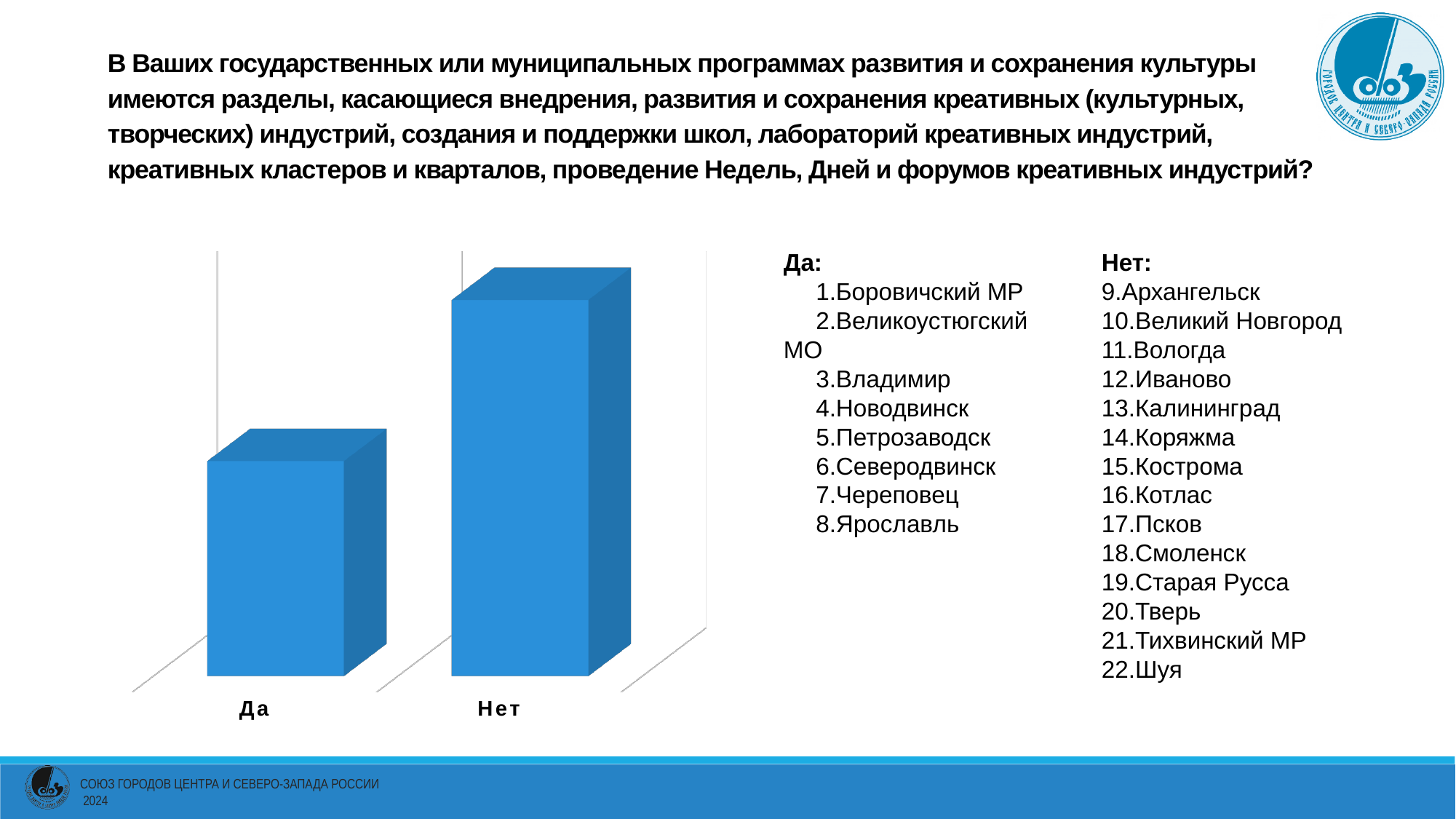
Which category has the highest bar in the chart? Нет What kind of chart is shown on the slide? bar chart What are the category labels on the x axis of the chart? Да, Нет How many categories are shown on the x axis of the chart? 2 Which bar is taller, Да or Нет? Нет What colour are the bars in the chart? blue Which category has the lowest bar in the chart? Да